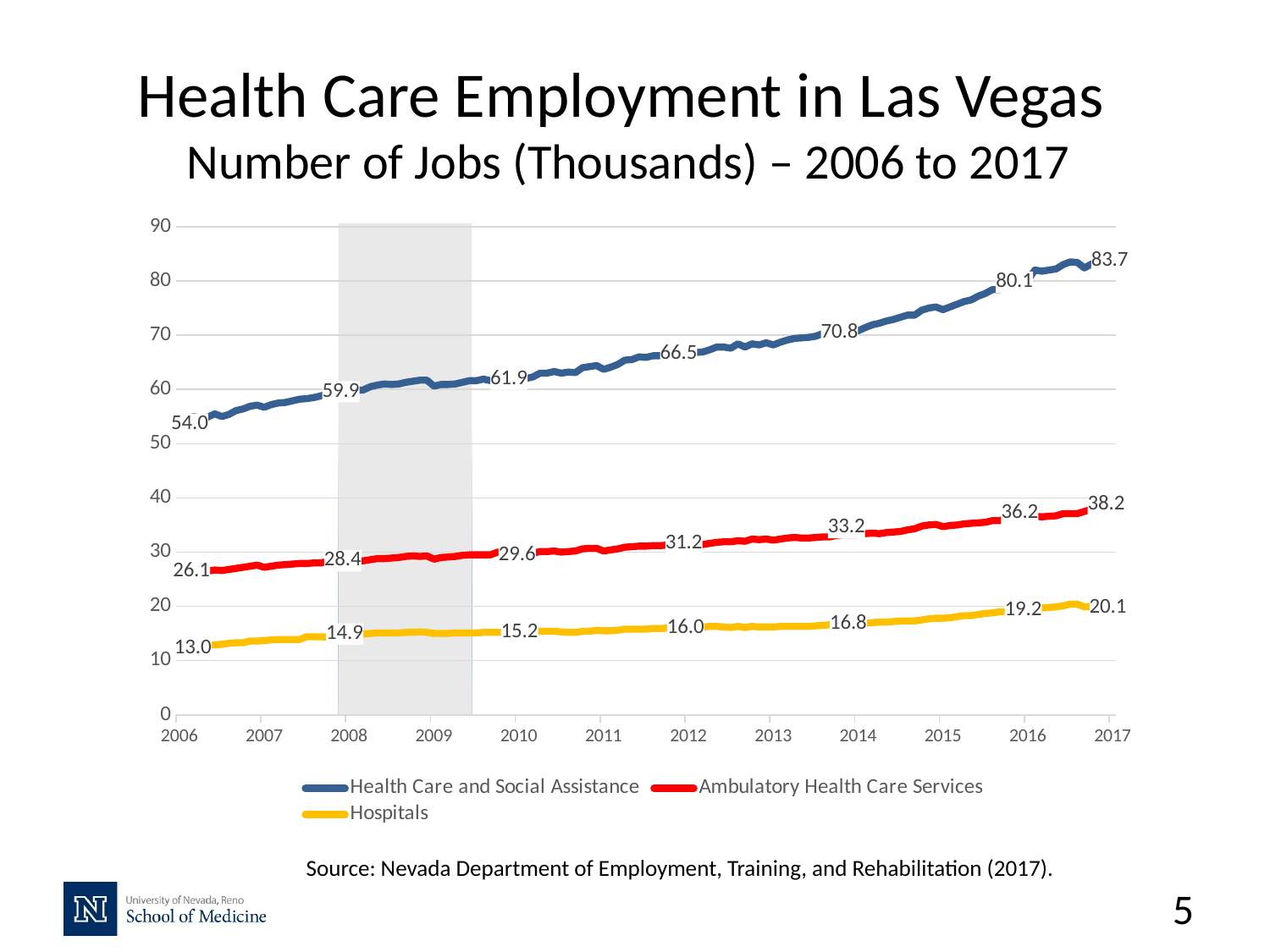
At the end of the period (2017), which is larger: Ambulatory Health Care Services or Hospitals? Ambulatory Health Care Services By how much did Ambulatory Health Care Services grow from its first labelled value (26.1) to its last labelled value (38.2)? 12.1 How many series does the legend list? 3 Which series has the lowest values throughout the chart? Hospitals Do the Hospitals values rise or fall from 2006 to 2017? rise What is the data label shown near 2014 for Ambulatory Health Care Services? 33.2 By how much did Health Care and Social Assistance grow from its first labelled value (54.0) to its last labelled value (83.7)? 29.7 What is the data label shown near 2008 for Health Care and Social Assistance? 59.9 Is the value for Ambulatory Health Care Services in 2011 greater or less than 40? less What is the last labelled value (at 2017) for Health Care and Social Assistance? 83.7 What is the first labelled value (at 2006) for Hospitals? 13.0 What kind of chart is shown on the slide? line chart